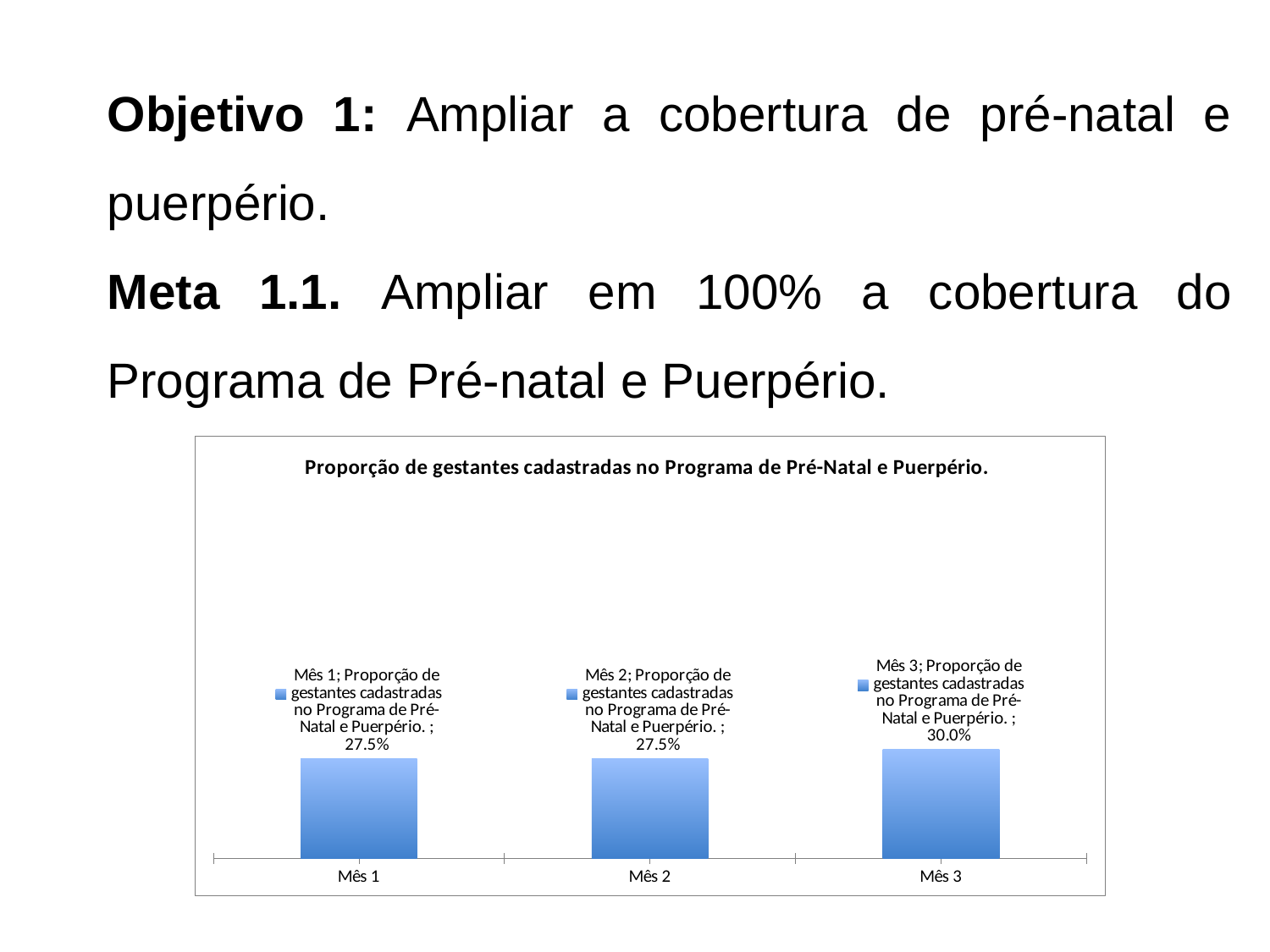
What is the difference between the values for Mês 3 and Mês 1? 2.5% What is the value for Mês 2? 27.5% Do the values rise or fall from Mês 1 to Mês 3? Rise Which is larger, the value for Mês 3 or the value for Mês 2? Mês 3 What is the title of the chart? Proporção de gestantes cadastradas no Programa de Pré-Natal e Puerpério. What is the value for Mês 1? 27.5% Which month has the highest value? Mês 3 What colour are the bars in the chart? Blue What kind of chart is shown on the slide? Bar chart What is the value for Mês 3? 30.0% How many months are shown on the x axis? 3